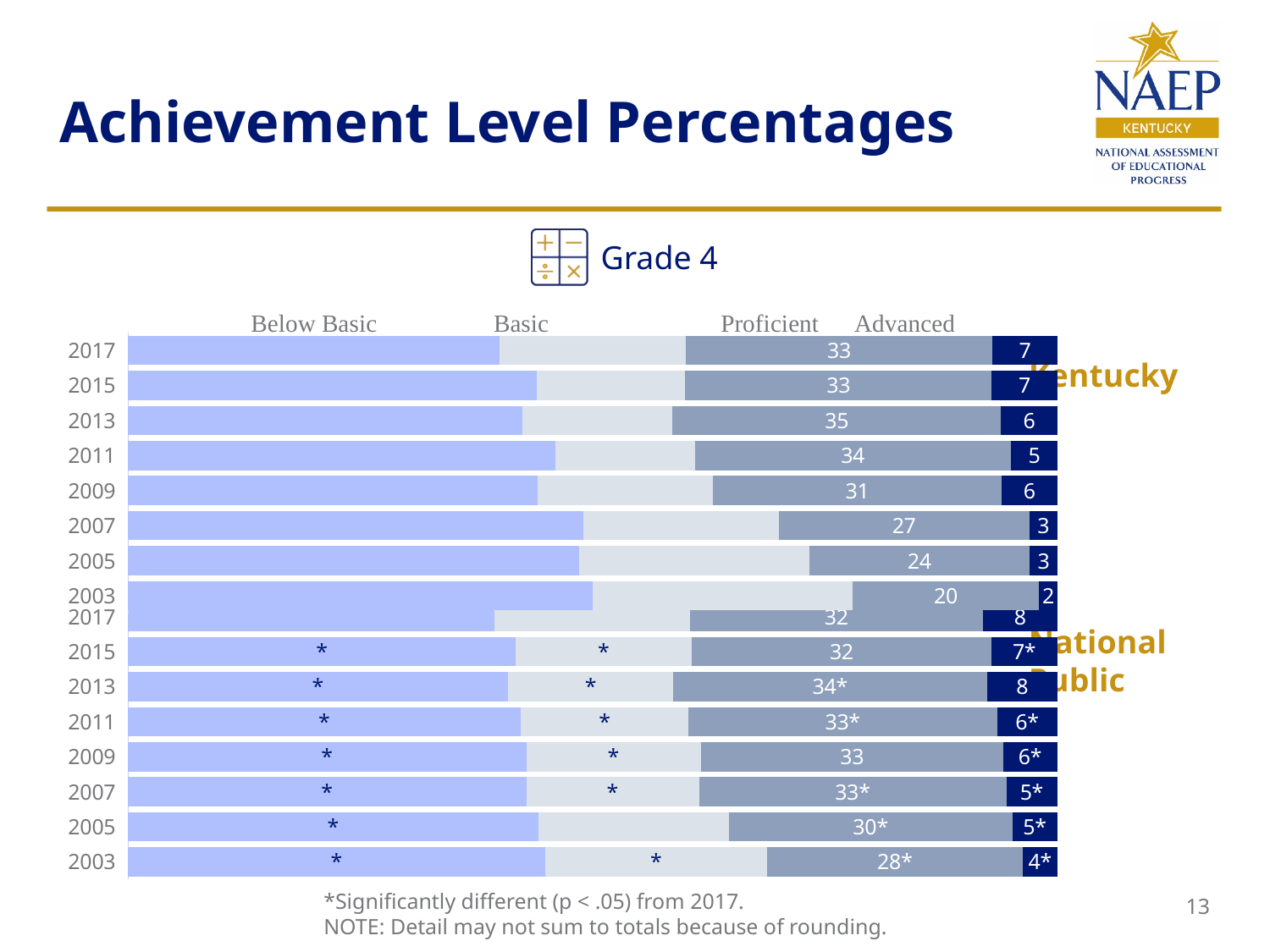
How many years are shown for the Kentucky group? 8 What is the Advanced percentage for Kentucky in 2003? 2 What is the Proficient percentage for Kentucky in 2013? 35 What kind of chart is shown on the slide? stacked bar chart How much higher is Kentucky's Proficient percentage in 2017 than in 2003? 13 In which year is Kentucky's Proficient percentage highest? 2013 Does Kentucky's Proficient percentage rise or fall from 2003 to 2013? rise What is the Advanced percentage for National Public in 2017? 8 What is the Proficient value shown for National Public in 2005? 30* Which year has the larger Advanced percentage for Kentucky, 2017 or 2011? 2017 How many achievement levels does the legend list? 4 In which year is Kentucky's Proficient percentage lowest? 2003